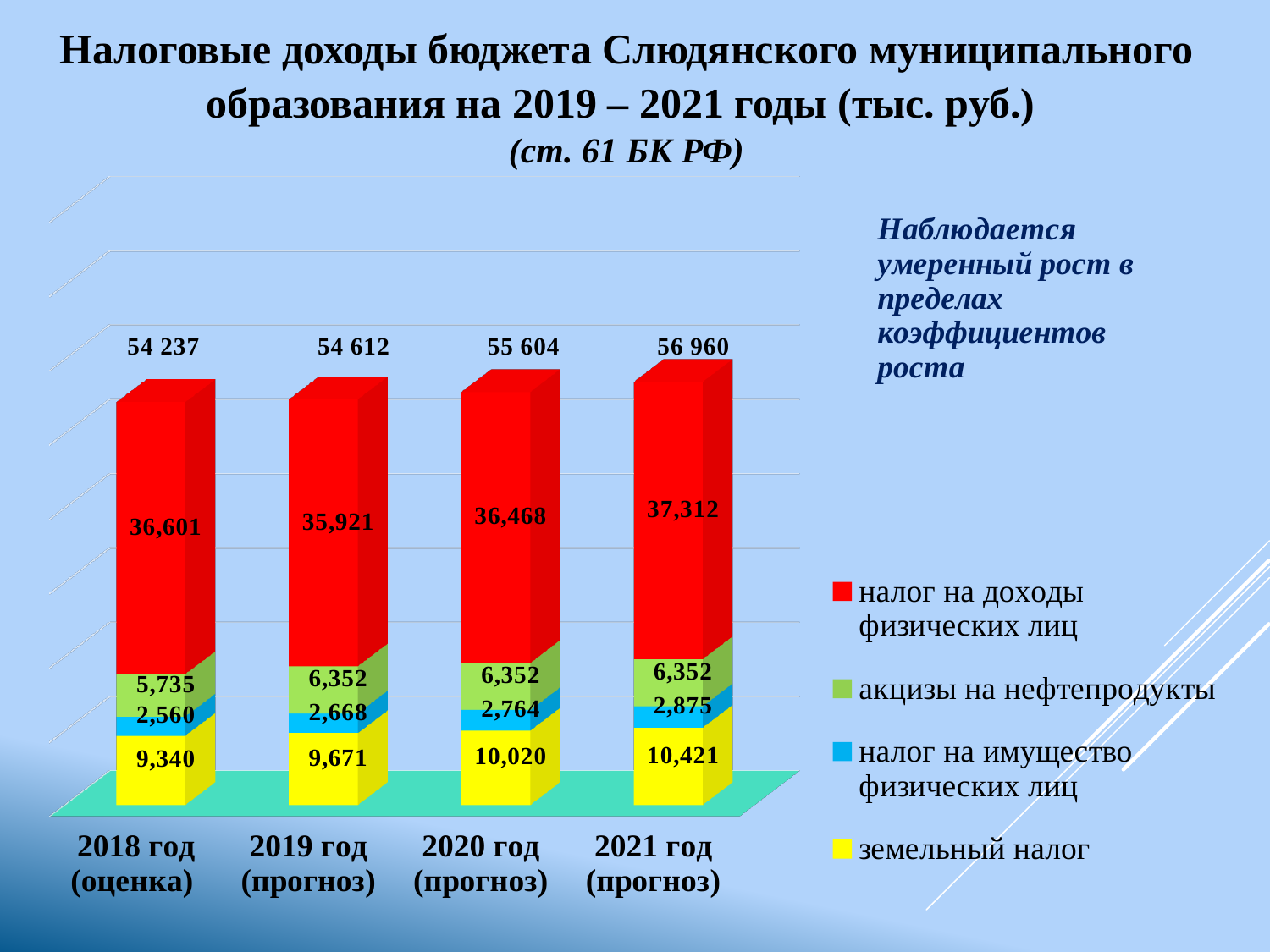
How many series does the legend list? 4 Which year has the highest total tax revenue? 2021 год (прогноз) Which is larger: налог на доходы физических лиц in 2019 год (прогноз) or in 2020 год (прогноз)? 2020 год (прогноз) What is the value of налог на имущество физических лиц for 2020 год (прогноз)? 2,764 What is the value of налог на доходы физических лиц for 2021 год (прогноз)? 37,312 What is the value of акцизы на нефтепродукты for 2019 год (прогноз)? 6,352 What is the difference between земельный налог in 2021 год (прогноз) and in 2018 год (оценка)? 1,081 Which year has the lowest value for земельный налог? 2018 год (оценка) What is the value of земельный налог for 2018 год (оценка)? 9,340 What kind of chart is shown on the slide? Stacked bar chart What is the total of the stacked bar for 2020 год (прогноз)? 55 604 Do the total tax revenues rise or fall from 2018 to 2021? Rise